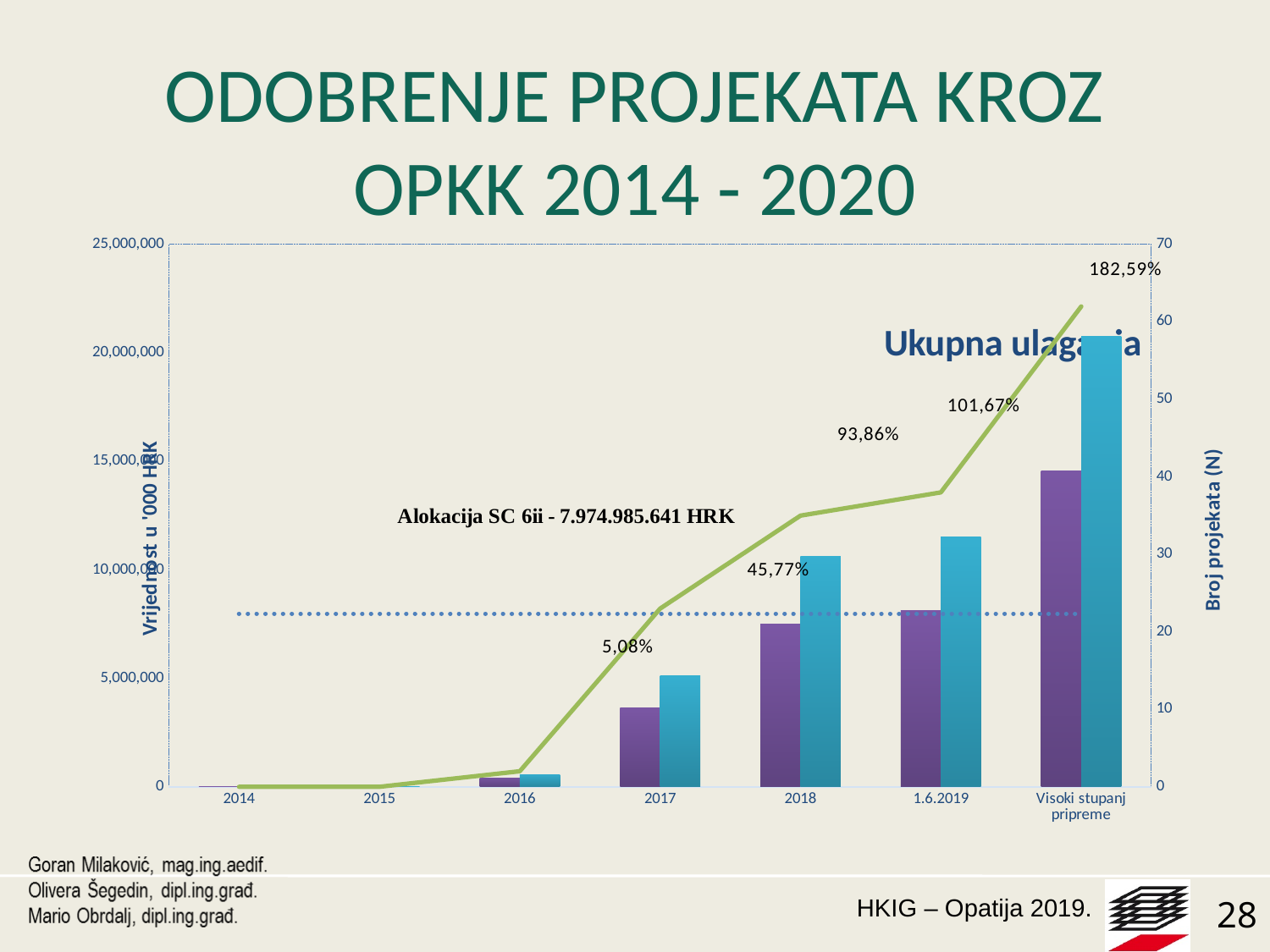
Is the purple bar for 2017 greater or less than 5,000,000 on the left axis? less What is the title of the left vertical axis of the chart? Vrijednost u '000 HRK Which has the taller teal bar, 2017 or 2018? 2018 Which category has the tallest teal bar? Visoki stupanj pripreme Is the teal bar for Visoki stupanj pripreme greater or less than 15,000,000 on the left axis? greater How many percentage labels are printed on the chart? 5 How many categories are shown along the x axis of the chart? 7 What allocation value for SC 6ii is printed on the chart? 7.974.985.641 HRK Does the green line rise or fall from 2014 to Visoki stupanj pripreme? rises What is the lowest percentage label shown on the chart? 5,08% What is the highest percentage label shown on the chart? 182,59% What kind of chart is shown on the slide? bar and line chart